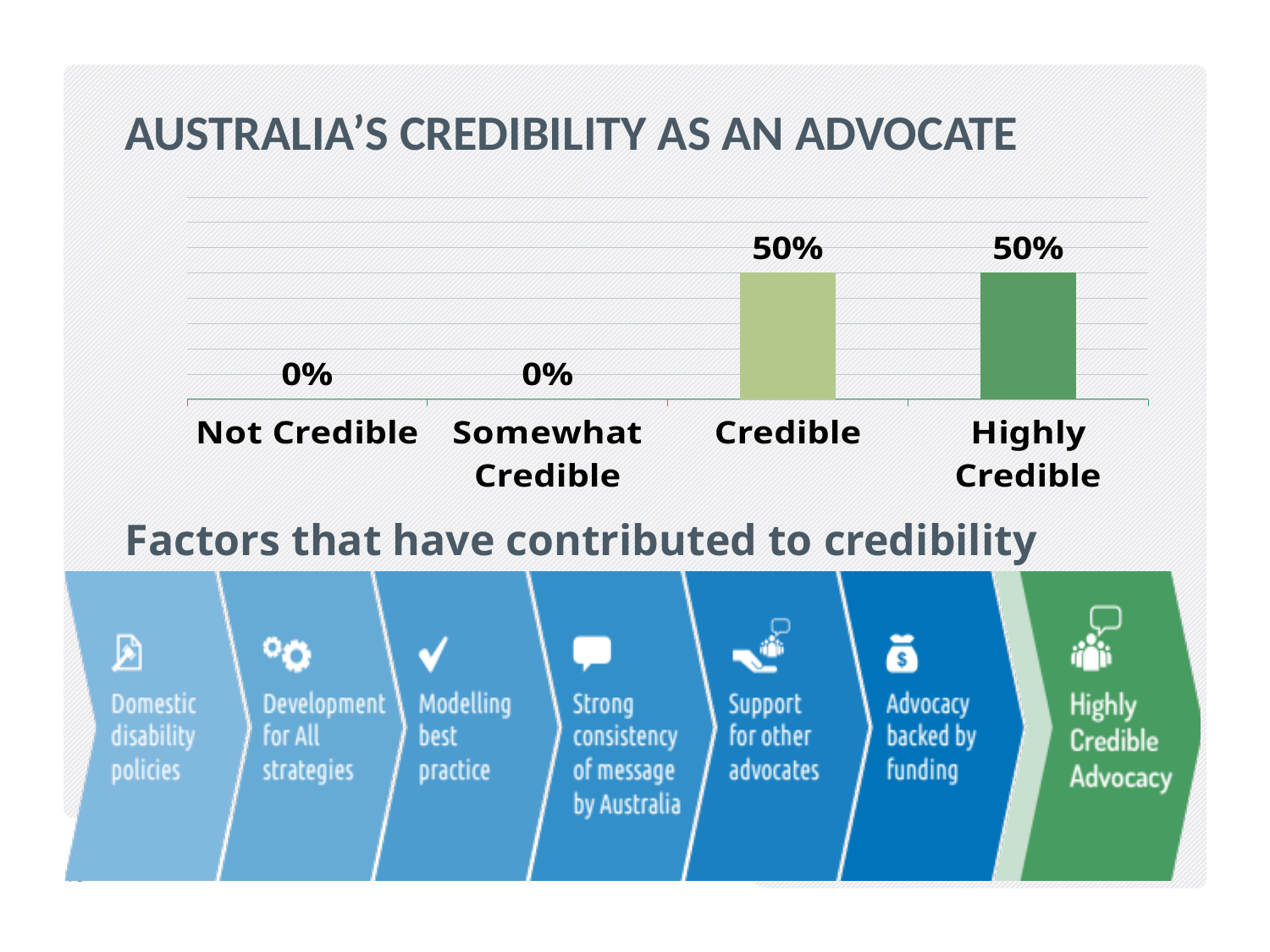
How many categories are shown on the x axis of the chart? 4 What is the value for Somewhat Credible? 0% Do the values rise or fall from Not Credible to Highly Credible along the x axis? Rise Which category's bar is the darker green? Highly Credible Which category has the lowest value, Not Credible or Credible? Not Credible What is the value for Credible? 50% What is the title of the chart? Australia's Credibility as an Advocate What kind of chart is shown on the slide? Bar chart What is the total of the values for Credible and Highly Credible? 100% What is the value for Not Credible? 0% What is the difference between the values for Highly Credible and Somewhat Credible? 50% What is the value for Highly Credible? 50%